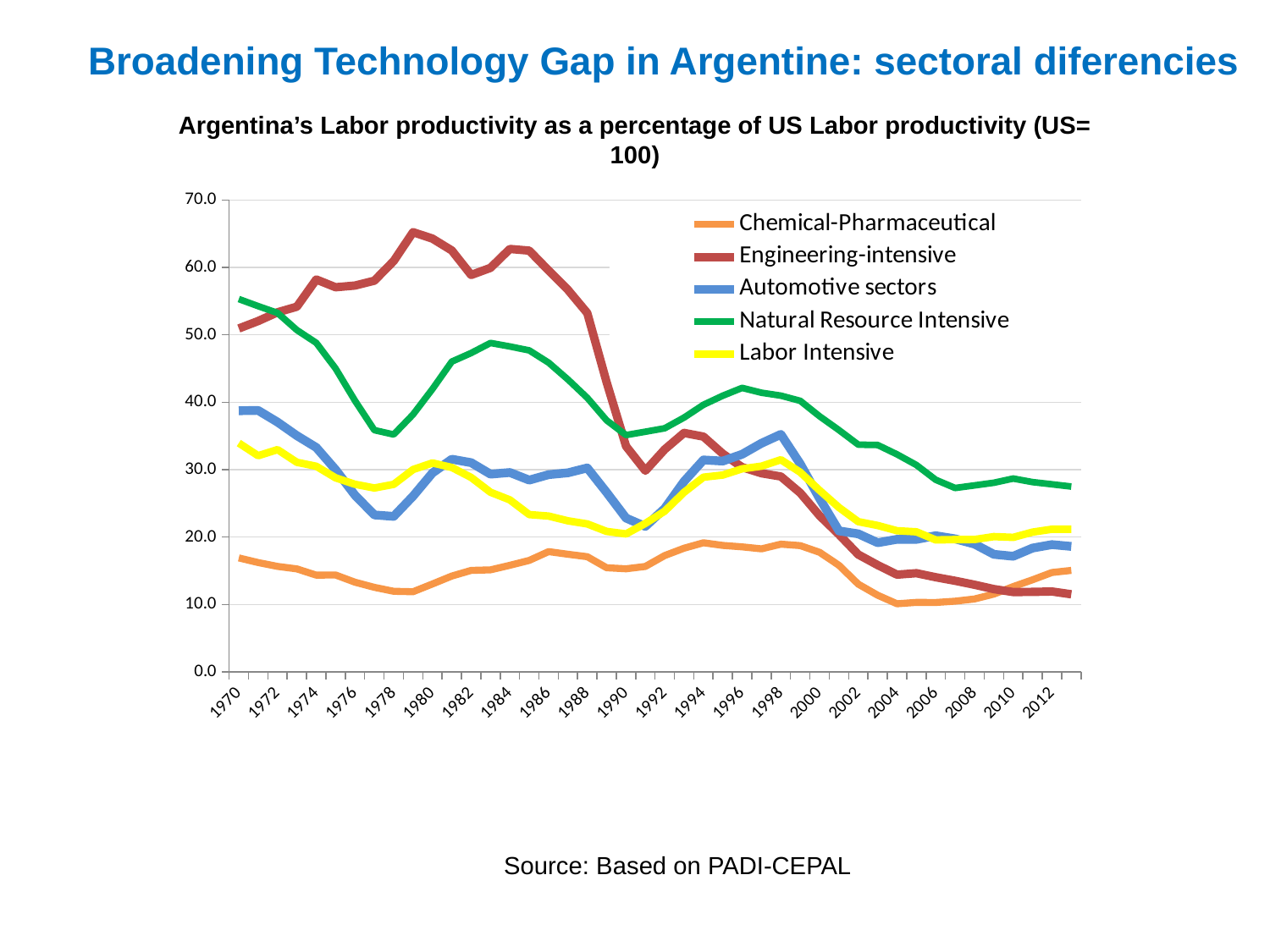
What is the title of the chart? Argentina's Labor productivity as a percentage of US Labor productivity (US= 100) Is the value for Chemical-Pharmaceutical in 1970 greater or less than 20.0? less Which series has the lowest value in 1970? Chemical-Pharmaceutical How many series does the legend list? 5 Which series has the highest value in 2013? Natural Resource Intensive Is the value for Labor Intensive in 1990 greater or less than 30.0? less In 2013, which is larger: Natural Resource Intensive or Engineering-intensive? Natural Resource Intensive What kind of chart is shown on the slide? line chart What colour is the Labor Intensive line? yellow Is the value for Engineering-intensive in 1979 greater or less than 60.0? greater Does the Engineering-intensive line rise or fall between 1988 and 1991? fall